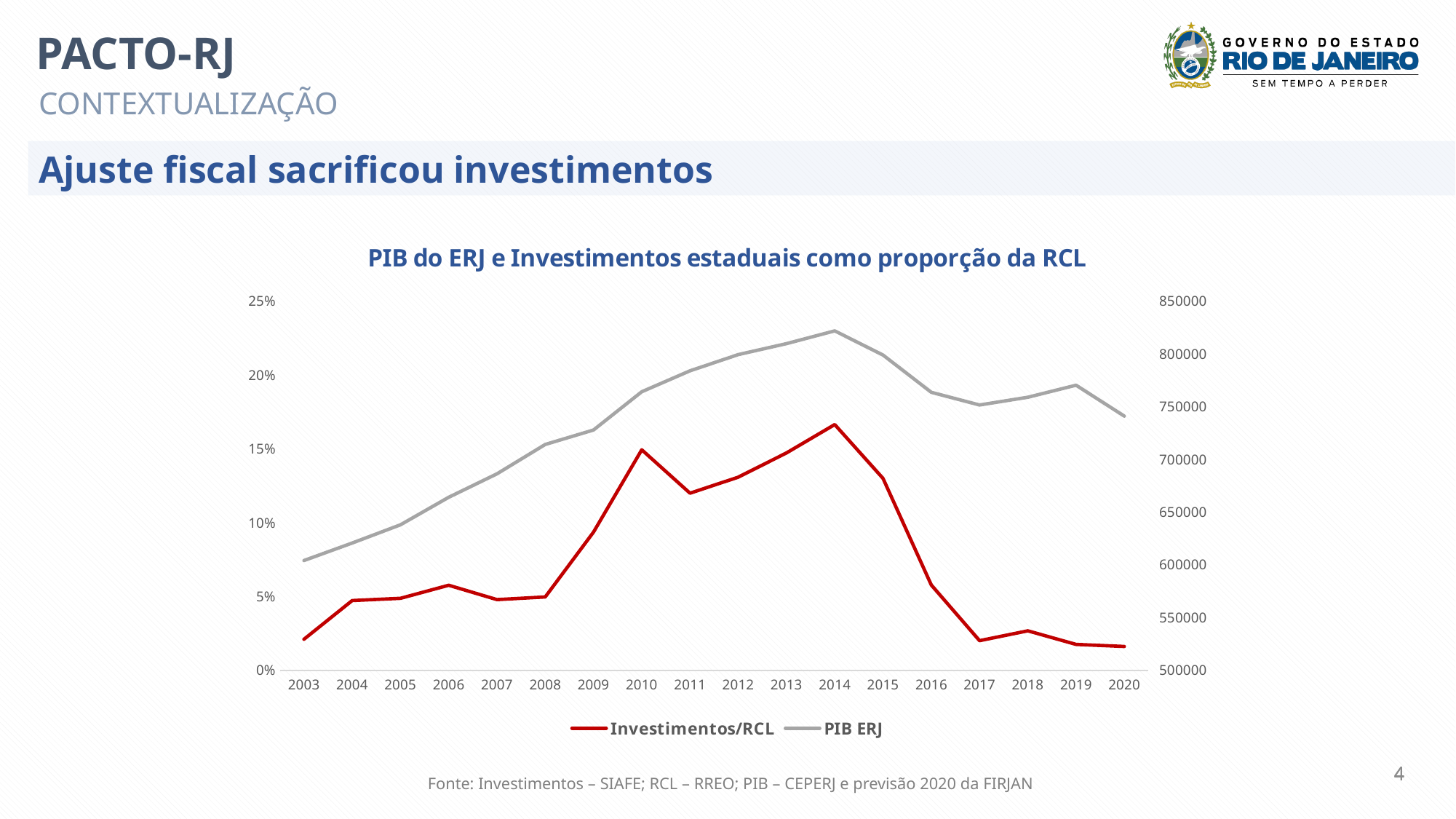
In which year does the Investimentos/RCL series reach its highest value? 2014 In which year is the PIB ERJ series at its lowest? 2003 What is the title of the chart? PIB do ERJ e Investimentos estaduais como proporção da RCL How many years are plotted along the x axis? 18 Which year has the larger Investimentos/RCL value, 2010 or 2011? 2010 How many series does the legend list? 2 Is the PIB ERJ value for 2014 greater or less than 800000? greater Does the Investimentos/RCL series rise or fall between 2014 and 2017? fall Is the Investimentos/RCL value for 2017 greater or less than 5%? less Is the Investimentos/RCL value for 2010 greater or less than 10%? greater What kind of chart is shown on the slide? line chart In which year does the PIB ERJ series reach its highest value? 2014